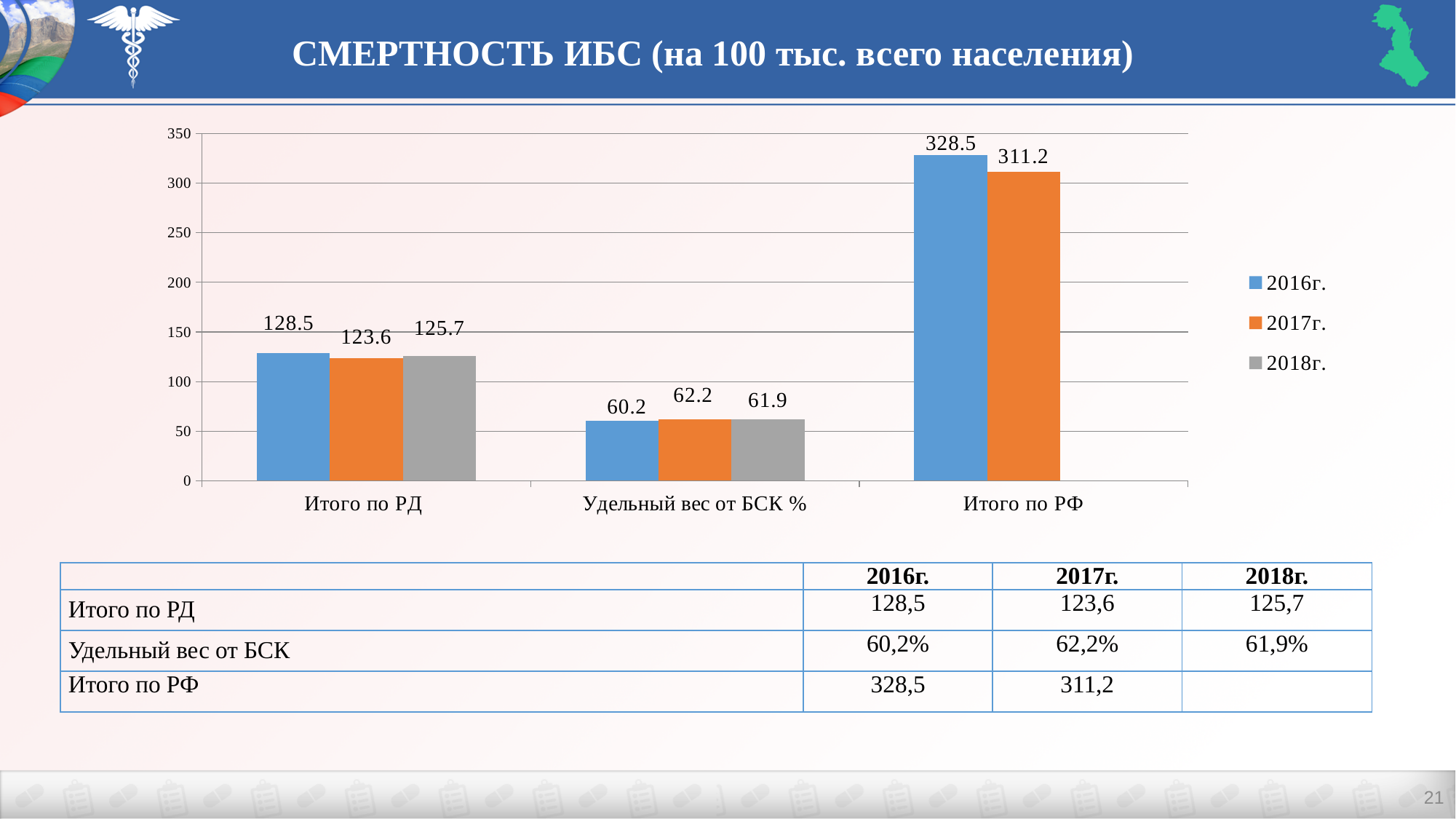
What is the value for Итого по РФ in 2017г.? 311.2 Is the value for Итого по РФ in 2016г. greater or less than 300? greater What is the value for Итого по РД in 2016г.? 128.5 How many categories are shown on the x axis? 3 What is the difference between the 2016г. and 2017г. values for Итого по РФ? 17.3 How many series does the legend list? 3 Which is larger for Итого по РД: the 2017г. value or the 2018г. value? 2018г. Which category has the highest value in 2016г.? Итого по РФ Which category has the lowest value in 2017г.? Удельный вес от БСК % Which colour represents 2017г. in the chart? orange What kind of chart is shown on the slide? bar chart What is the value for Удельный вес от БСК % in 2018г.? 61.9